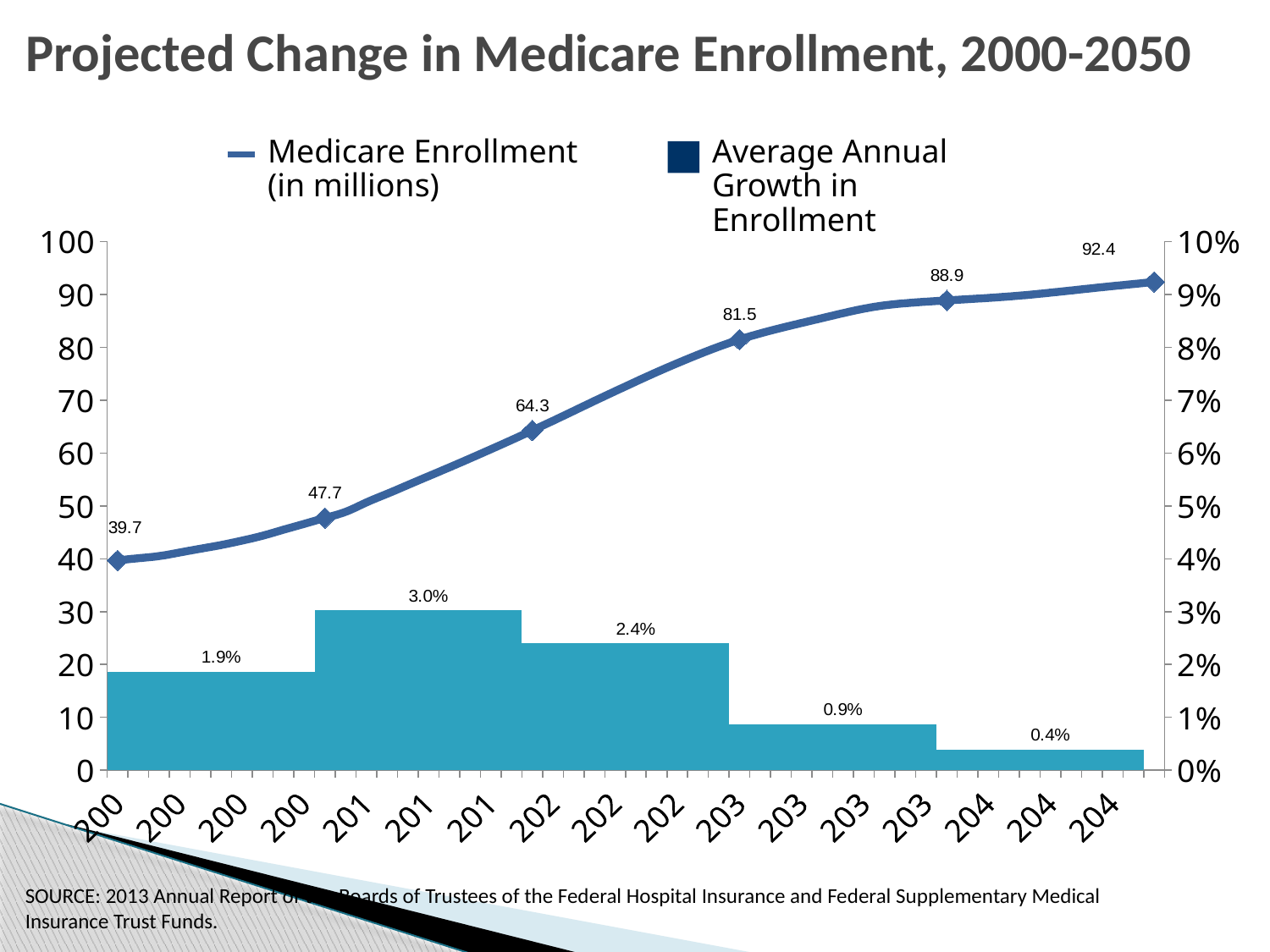
What is the difference between the highest and lowest values on the Medicare Enrollment line? 52.7 What is the difference between the highest and lowest Average Annual Growth in Enrollment bars? 2.6% How many data points are labeled on the Medicare Enrollment (in millions) line? 6 Which is larger: the first Average Annual Growth bar (1.9%) or the third bar (2.4%)? The third bar (2.4%) What kind of chart is shown on the slide? A combined line and bar chart What is the lowest value on the Medicare Enrollment (in millions) line? 39.7 How many series does the legend list? 2 Does the Medicare Enrollment (in millions) line rise or fall from left to right? Rises What is the highest value on the Medicare Enrollment (in millions) line? 92.4 What is the lowest Average Annual Growth in Enrollment value shown on the bars? 0.4% How many Average Annual Growth in Enrollment bars are shown? 5 What is the highest Average Annual Growth in Enrollment value shown on the bars? 3.0%